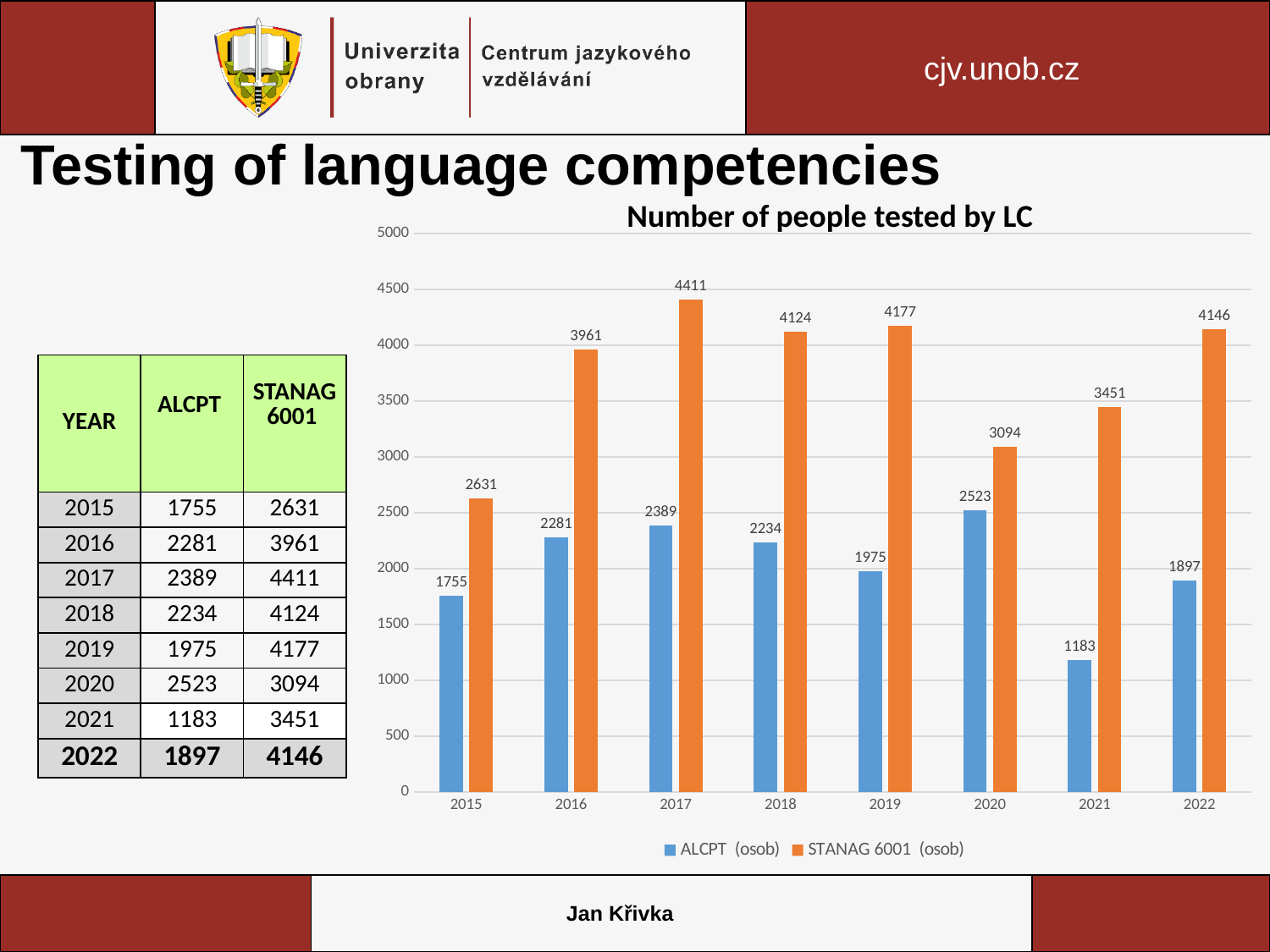
Which is larger, the ALCPT value for 2020 or the ALCPT value for 2016? ALCPT value for 2020 What is the ALCPT value for 2017? 2389 Does the STANAG 6001 value rise or fall from 2015 to 2017? rise Which year has the highest STANAG 6001 value? 2017 What is the difference between the STANAG 6001 and ALCPT values in 2019? 2202 Which year has the lowest ALCPT value? 2021 What is the STANAG 6001 value for 2020? 3094 Is the STANAG 6001 value for 2015 greater or less than 2500? greater How many years are shown on the x axis? 8 What kind of chart is shown? bar chart How many series does the legend list? 2 What is the title of the chart? Number of people tested by LC